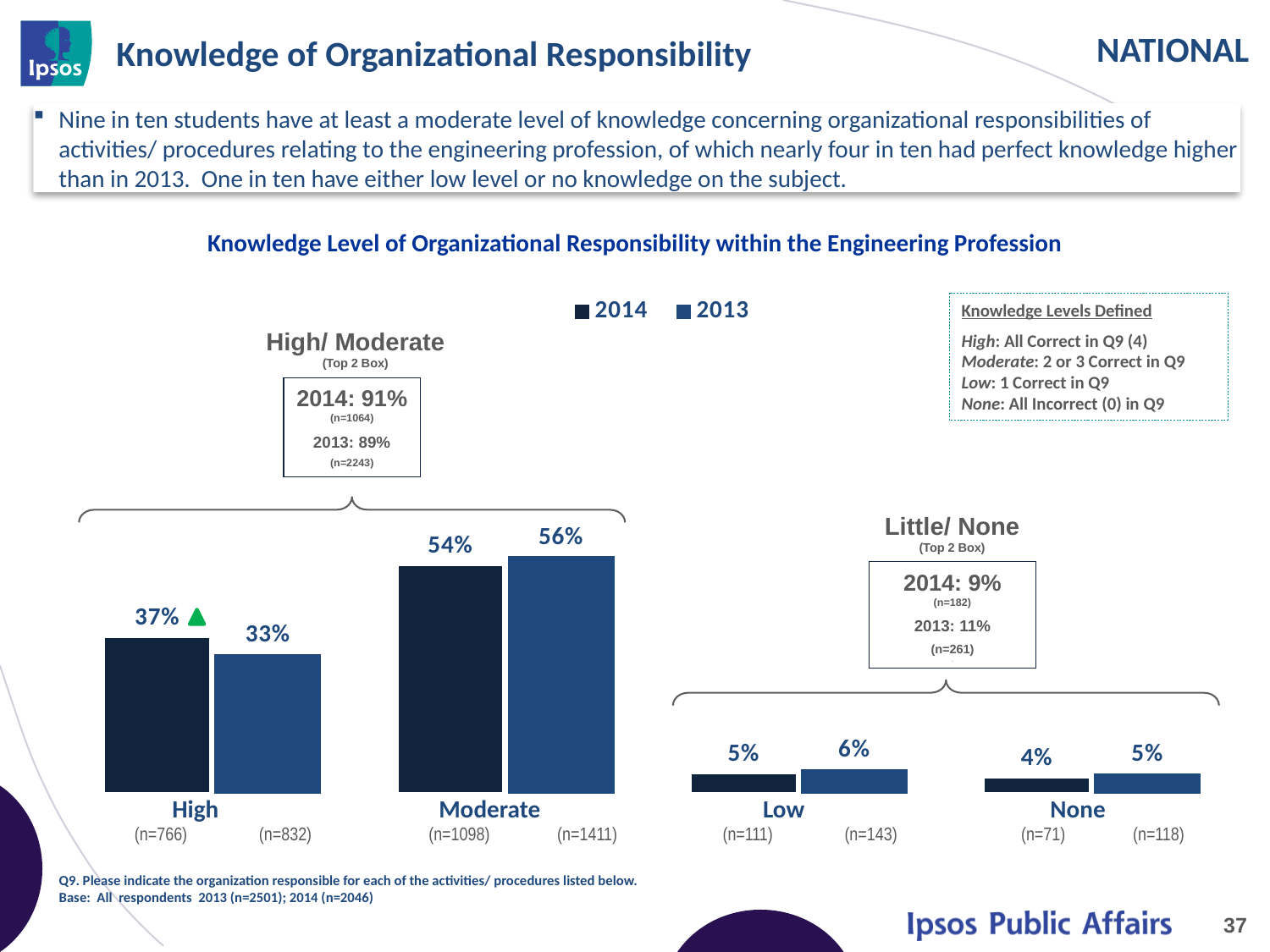
What is the title of the chart? Knowledge Level of Organizational Responsibility within the Engineering Profession Which knowledge level category has the highest value for 2014? Moderate Which knowledge level category has the lowest value for 2013? None What is the 2014 value for the None category? 4% How many knowledge level categories are shown on the x axis of the chart? 4 What percentage of students had a Moderate knowledge level in 2013? 56% What percentage of students had a High knowledge level in 2014? 37% What type of chart is used to show the knowledge levels? Bar chart How many series does the chart legend list? 2 What is the difference between the 2014 and 2013 values for the High category? 4% Which is larger for the Moderate category, the 2014 value or the 2013 value? 2013 What is the combined High/Moderate (Top 2 Box) value for 2014 shown on the chart? 91%